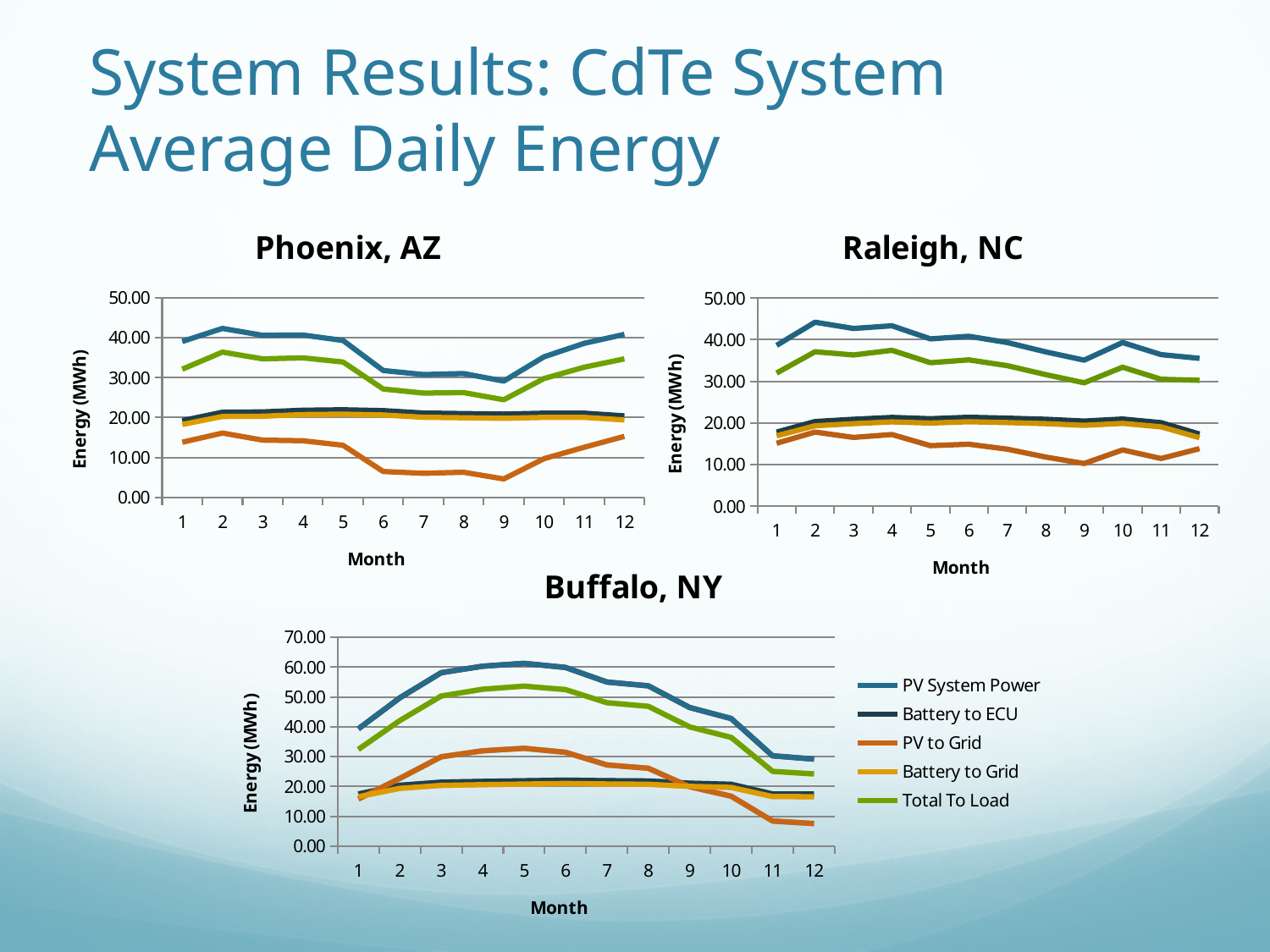
How many months are plotted along the x axis of the Buffalo, NY chart? 12 How many series does the legend on the slide list? 5 In the Buffalo, NY chart, which is larger: PV System Power in month 5 or in month 12? Month 5 In the Buffalo, NY chart, is the PV System Power value for month 5 greater or less than 50.00? greater In the Phoenix, AZ chart, is the PV System Power value for month 2 greater or less than 40.00? greater In the Buffalo, NY chart, is the Total To Load value for month 12 greater or less than 30.00? less What is the y-axis label on the Raleigh, NC chart? Energy (MWh) What kind of chart is the Phoenix, AZ chart? Line chart In the Phoenix, AZ chart, in which month is PV to Grid lowest? 9 In the Phoenix, AZ chart, does PV to Grid rise or fall from month 5 to month 9? Fall In the Buffalo, NY chart, does PV System Power rise or fall from month 5 to month 12? Fall